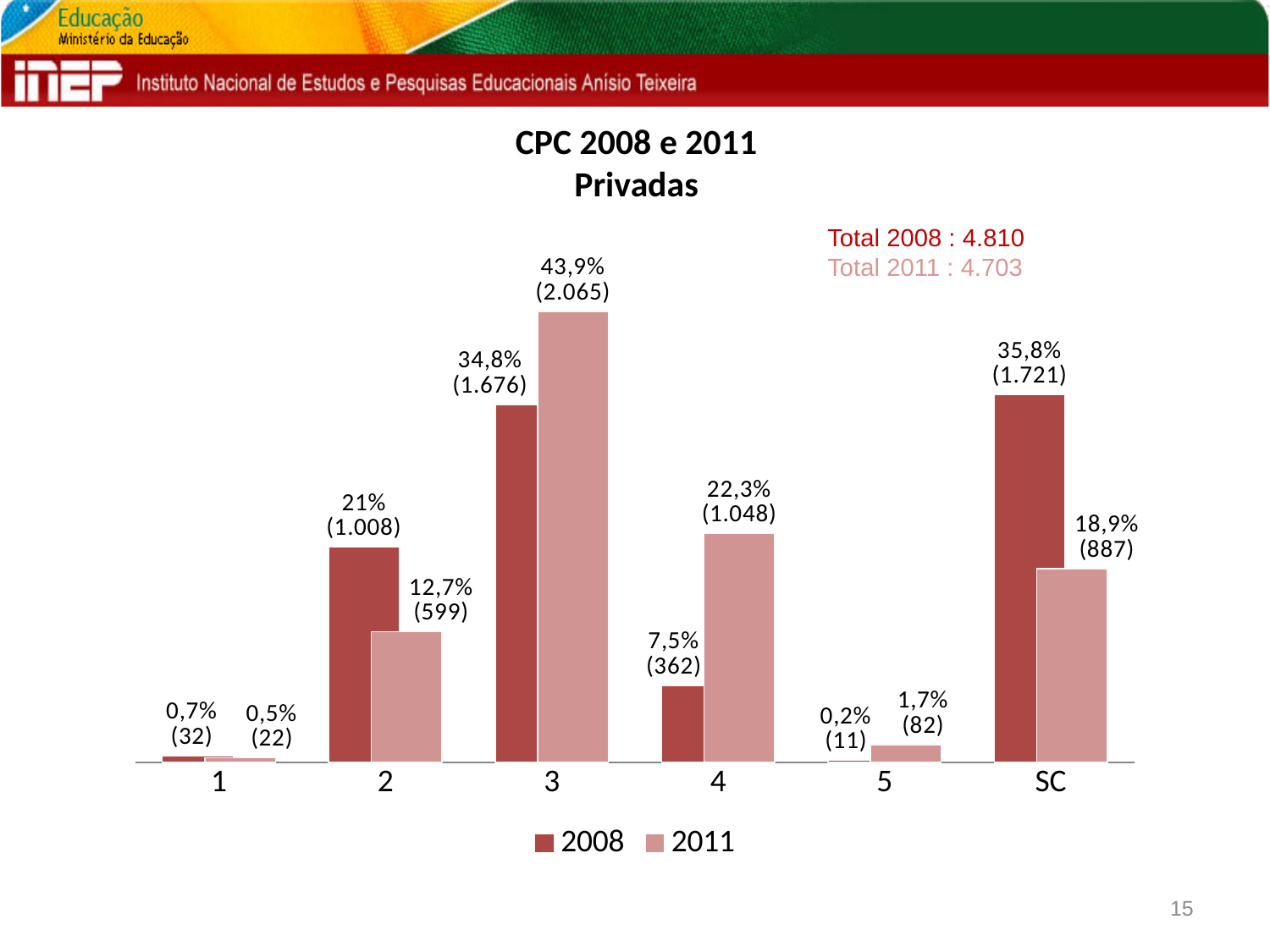
Which is larger for category 4: the 2008 value or the 2011 value? 2011 Which category has the lowest value in the 2008 series? 5 What is the difference between the 2011 count and the 2008 count for category 3? 389 What is the percentage for category SC in the 2008 series? 35,8% How many categories are shown on the x axis? 6 Which category has the highest value in the 2011 series? 3 How many series does the legend list? 2 What total is given for 2008 on the slide? 4.810 What is the count shown in parentheses for category 2 in the 2008 series? 1.008 What kind of chart is shown on the slide? bar chart What is the difference in percentage points between the 2008 and 2011 values for category SC? 16,9 What is the percentage for category 3 in the 2011 series? 43,9%